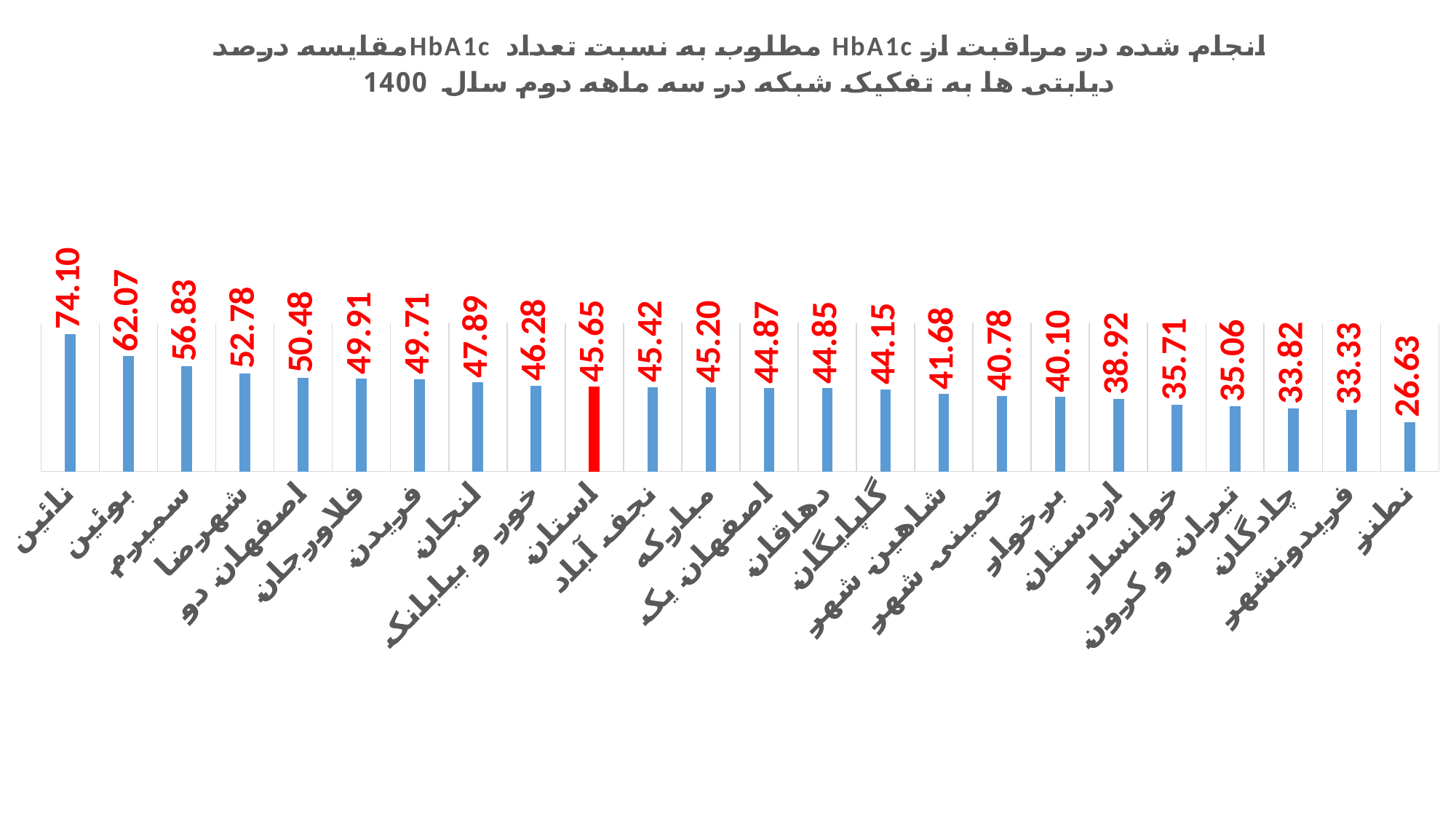
Which is larger, the value for سمیرم or the value for شهرضا? سمیرم Which category has the lowest value? نطنز What is the value for نطنز? 26.63 What is the difference between the values for نائین and بوئین? 12.03 What is the value for نائین? 74.10 What is the value for گلپایگان? 44.15 Which bar is coloured red instead of blue? استان Which category has the highest value? نائین How many categories are shown in the chart? 24 What is the difference between the values for استان and نطنز? 19.02 What kind of chart is shown on the slide? bar chart What is the value for استان (the red bar)? 45.65